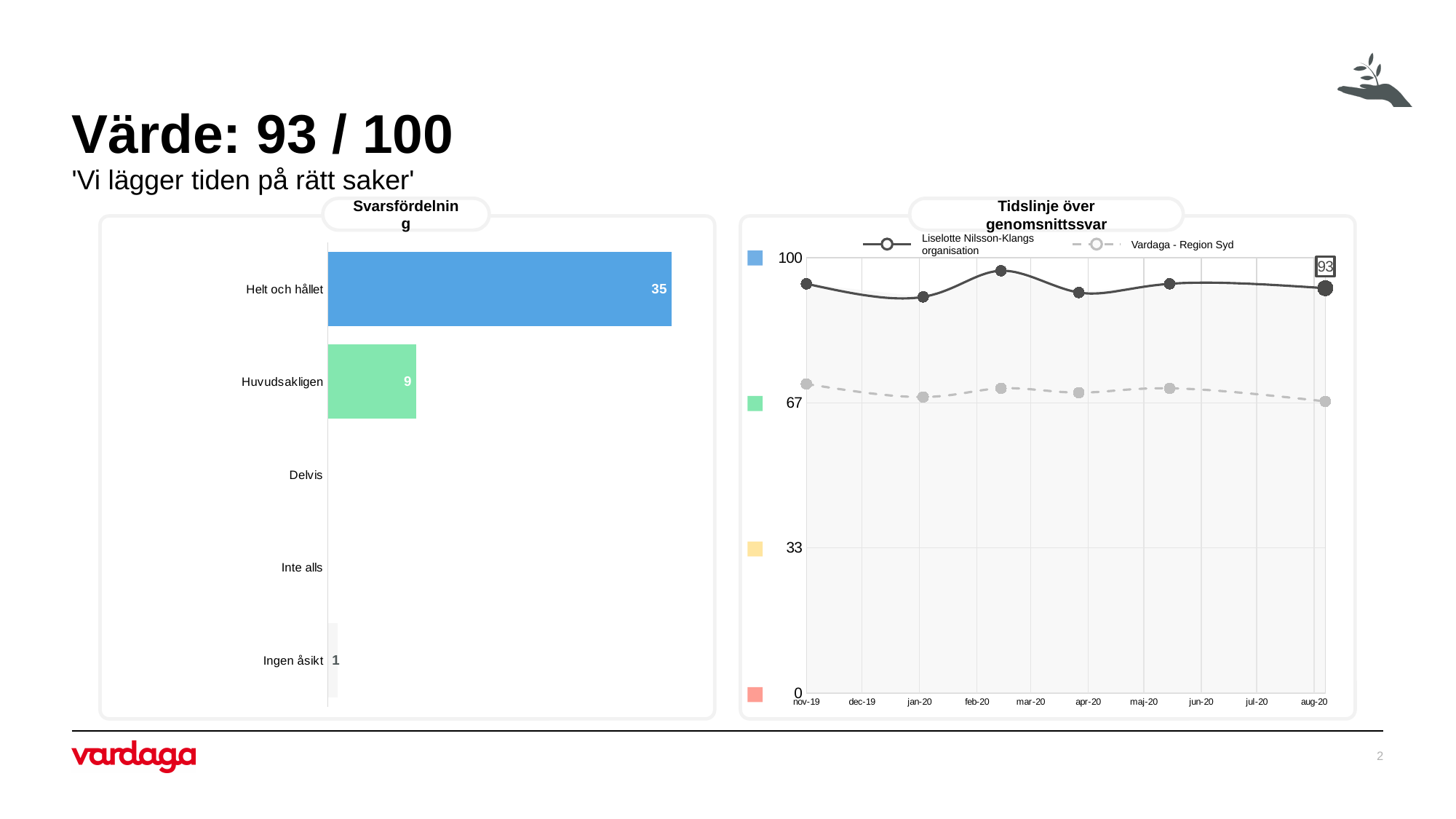
In the Svarsfördelning chart, what is the difference between Helt och hållet and Huvudsakligen? 26 In the Svarsfördelning chart, what is the value for Helt och hållet? 35 In the Tidslinje över genomsnittssvar chart, which series is higher at aug-20, Liselotte Nilsson-Klangs organisation or Vardaga - Region Syd? Liselotte Nilsson-Klangs organisation In the Svarsfördelning chart, which category has the highest value? Helt och hållet What kind of chart is the Svarsfördelning chart? Bar chart In the Svarsfördelning chart, what is the value for Huvudsakligen? 9 How many categories are listed on the axis of the Svarsfördelning chart? 5 In the Tidslinje över genomsnittssvar chart, is the value for Vardaga - Region Syd at nov-19 greater or less than 33? greater In the Tidslinje över genomsnittssvar chart, what is the value for Liselotte Nilsson-Klangs organisation at aug-20? 93 In the Svarsfördelning chart, which is larger, Huvudsakligen or Ingen åsikt? Huvudsakligen In the Svarsfördelning chart, what is the value for Ingen åsikt? 1 How many series does the legend of the Tidslinje över genomsnittssvar chart list? 2